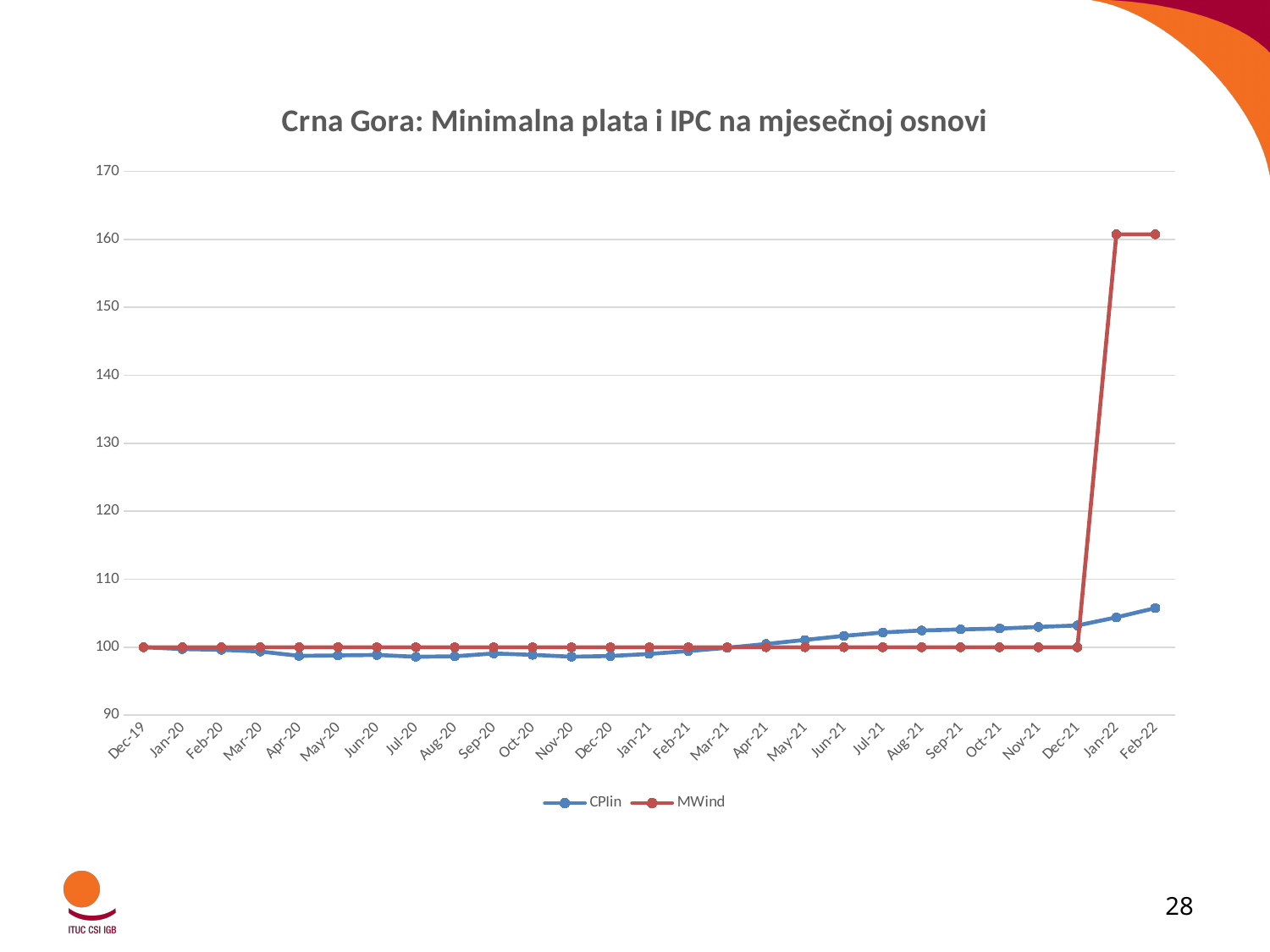
Does the CPIin series rise or fall between Mar-21 and Feb-22? rise Which series has the higher value in Feb-22, CPIin or MWind? MWind What is the title of the chart? Crna Gora: Minimalna plata i IPC na mjesečnoj osnovi Is the value for CPIin in Feb-22 greater or less than 110? less Does the MWind series rise or fall between Dec-21 and Jan-22? rise How many months are plotted along the x axis? 27 Is the value for MWind in Jan-22 greater or less than 150? greater What kind of chart is shown on the slide? line chart Which series has the higher value in Dec-21, CPIin or MWind? CPIin What are the names of the two series in the legend? CPIin and MWind Is the value for MWind in Dec-21 greater or less than 110? less How many series does the legend list? 2